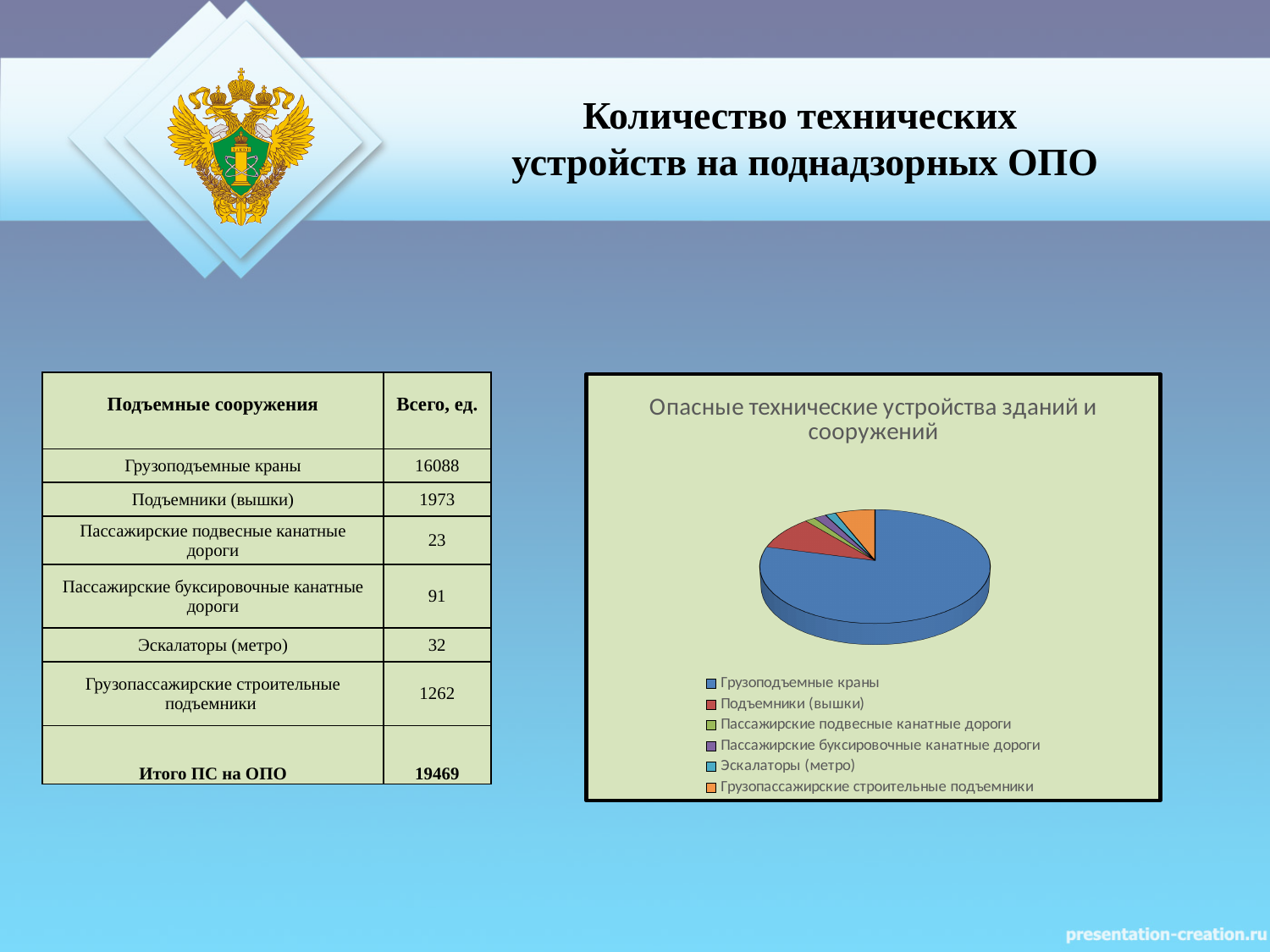
Which is larger in the table: Пассажирские буксировочные канатные дороги or Эскалаторы (метро)? Пассажирские буксировочные канатные дороги What is the total (Итого ПС на ОПО) shown in the table? 19469 According to the table, what is the value for Грузоподъемные краны? 16088 What kind of chart is shown on the slide? pie chart According to the table, what is the value for Подъемники (вышки)? 1973 How many categories does the pie chart's legend list? 6 What is the difference between the values for Грузоподъемные краны and Подъемники (вышки) in the table? 14115 Which category has the largest slice in the pie chart? Грузоподъемные краны According to the table, which category has the smallest value? Пассажирские подвесные канатные дороги According to the table, what is the value for Эскалаторы (метро)? 32 What is the title of the pie chart? Опасные технические устройства зданий и сооружений According to the table, what is the value for Грузопассажирские строительные подъемники? 1262